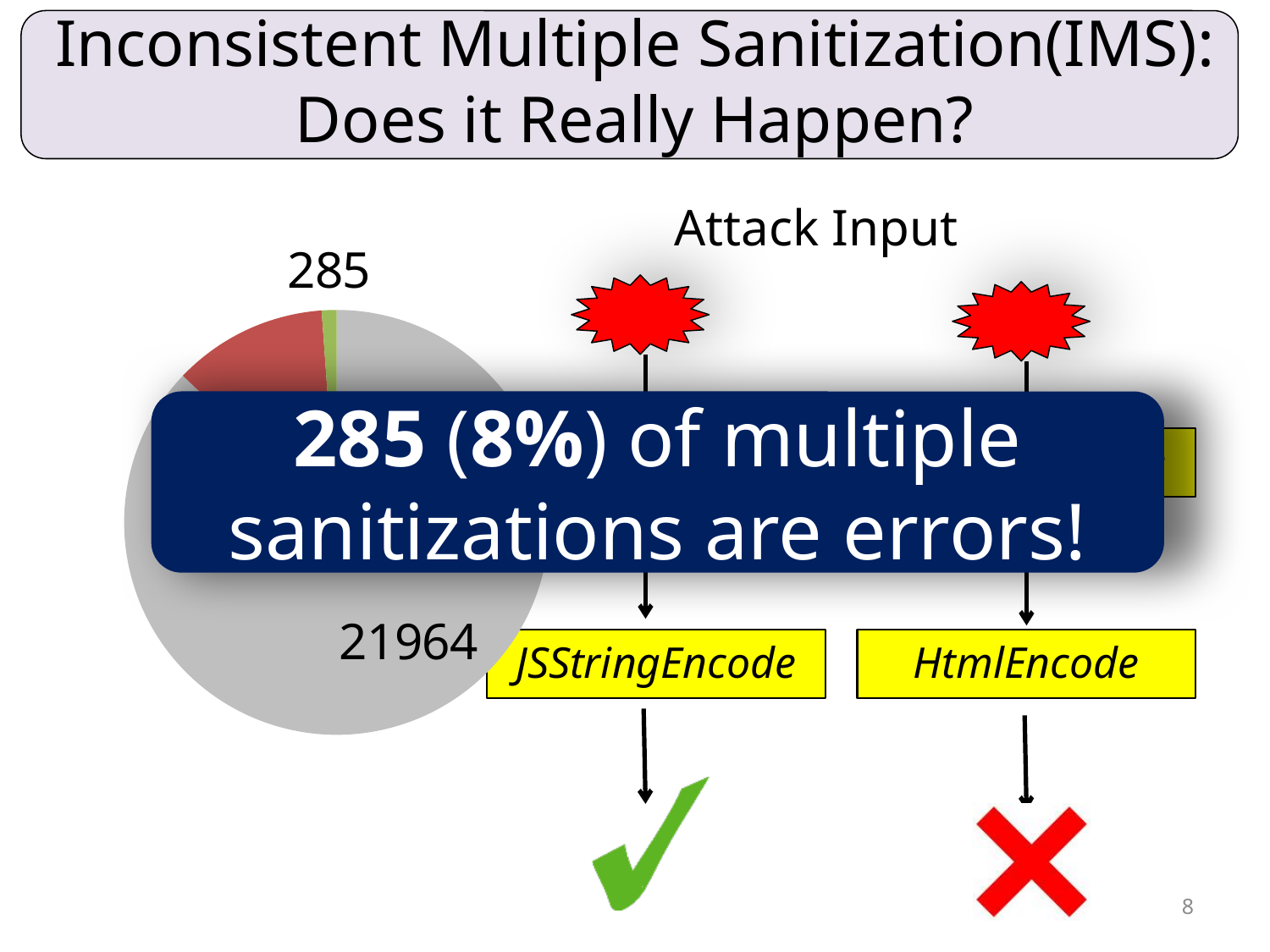
Which labelled value in the pie chart is the largest? 21964 What is the value labelled on the largest (gray) slice of the pie chart? 21964 Which labelled value in the pie chart is the smallest? 285 What is the difference between the two labelled values in the pie chart, 21964 and 285? 21679 According to the banner over the chart, what percentage of multiple sanitizations are errors? 8% Which is larger in the pie chart, the slice labelled 21964 or the slice labelled 285? 21964 What value is labelled on the small green slice of the pie chart? 285 What kind of chart is shown on the left of the slide? pie chart What colour is the largest slice of the pie chart? gray